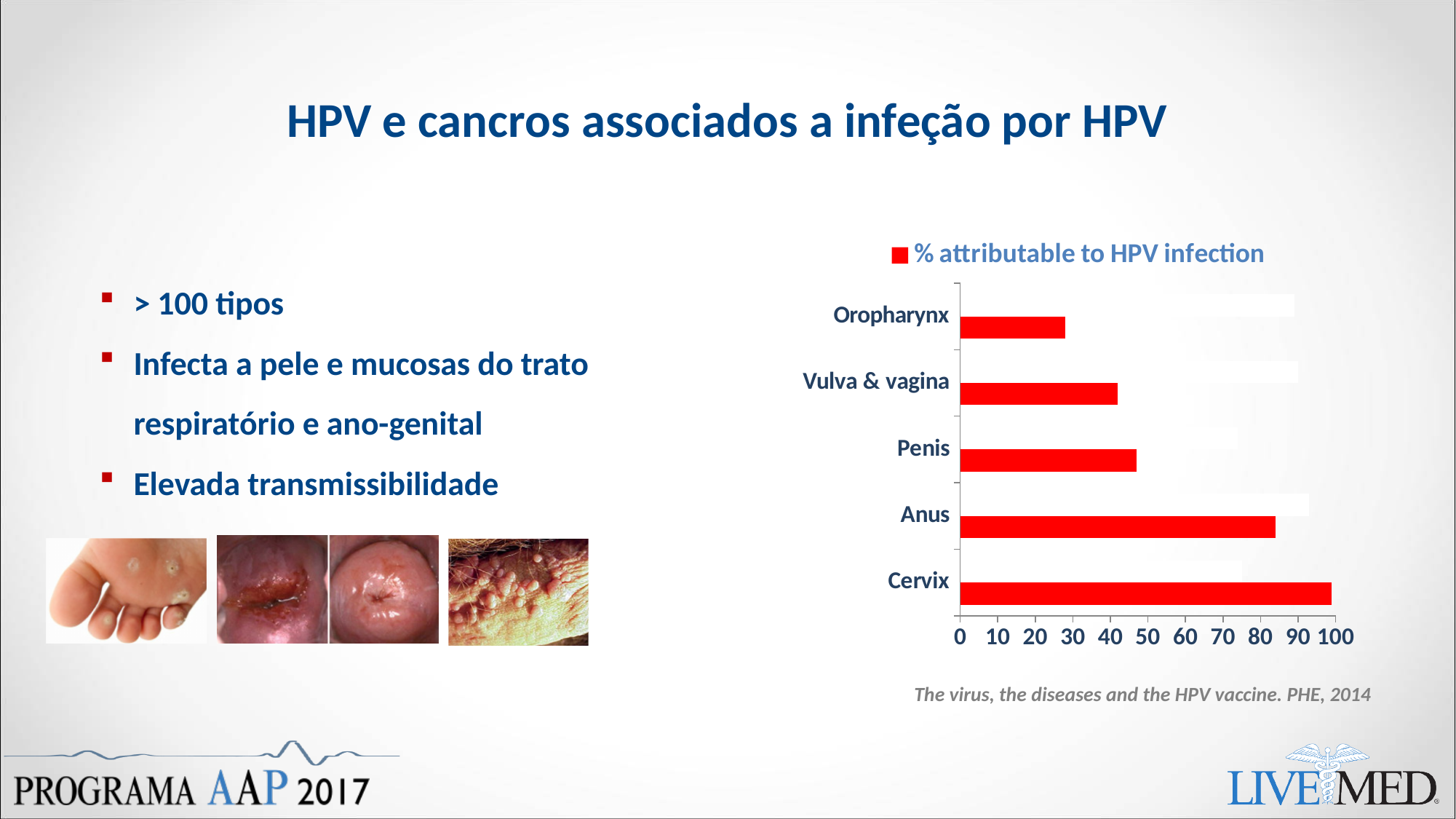
Which has a higher % attributable to HPV infection, Anus or Penis? Anus How many series does the chart legend list? 1 Which has a higher % attributable to HPV infection, Oropharynx or Cervix? Cervix What is the legend entry for the series in the chart? % attributable to HPV infection What kind of chart is shown on the slide? bar chart Is the value for Cervix greater or less than 90? greater Is the value for Oropharynx greater or less than 40? less Which category has the lowest % attributable to HPV infection? Oropharynx How many categories are plotted in the chart? 5 Which category has the highest % attributable to HPV infection? Cervix What colour are the bars in the chart? red Is the value for Anus greater or less than 70? greater